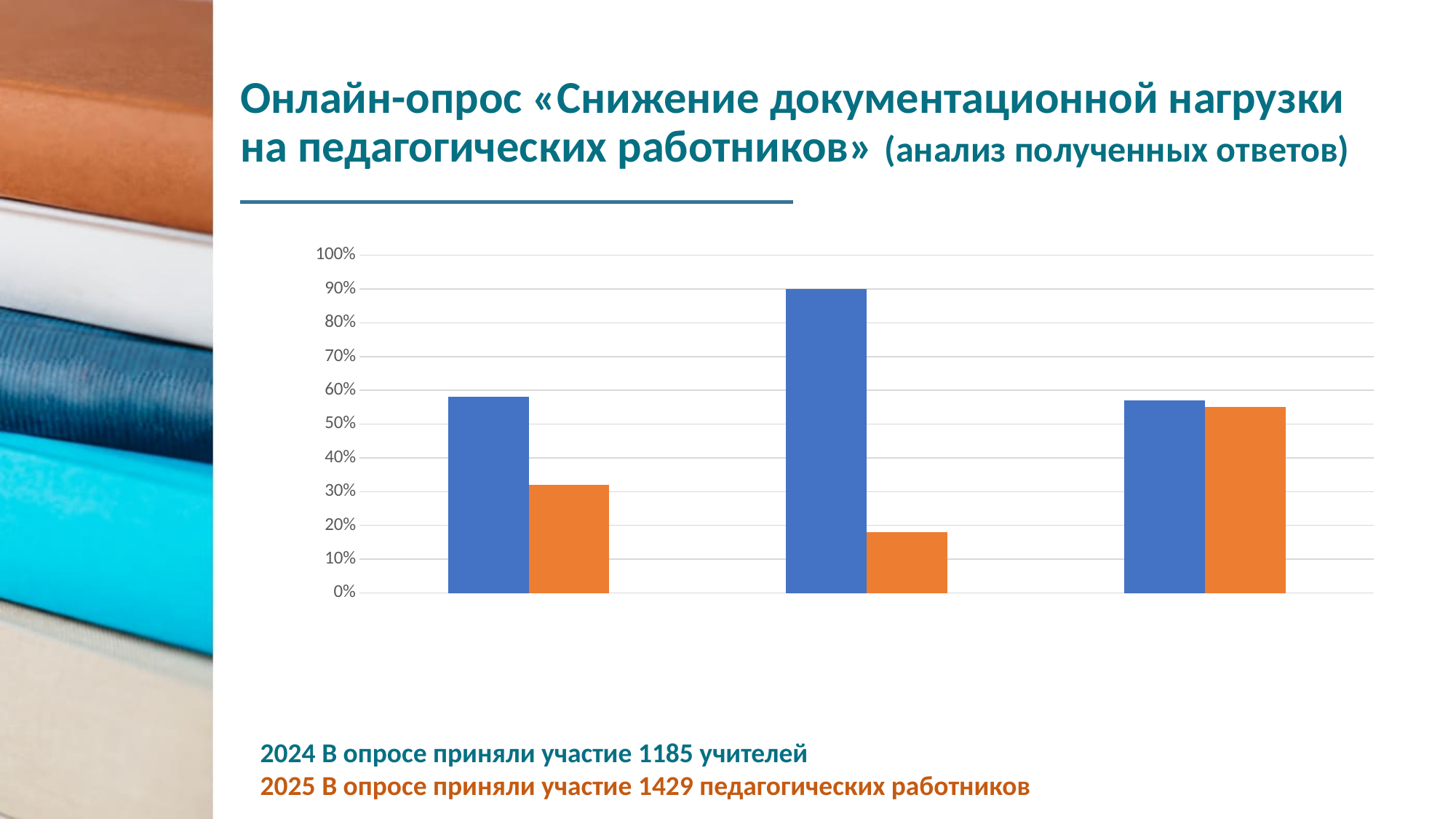
What value does the blue bar in the middle group reach on the axis? 90% Is the value of the orange bar in the left group greater or less than 40%? less Which group of bars has the shortest orange bar? the middle group Is the value of the orange bar in the middle group greater or less than 30%? less In the first (left) group, which bar is taller, the blue one or the orange one? the blue one What kind of chart is shown on the slide? bar chart In the middle group, which bar is taller, the blue one or the orange one? the blue one Is the value of the blue bar in the left group greater or less than 50%? greater Which group of bars has the tallest blue bar? the middle group How many differently coloured bar series are plotted in the chart? 2 What is the highest value shown on the vertical axis of the chart? 100% How many groups of bars does the chart show? 3